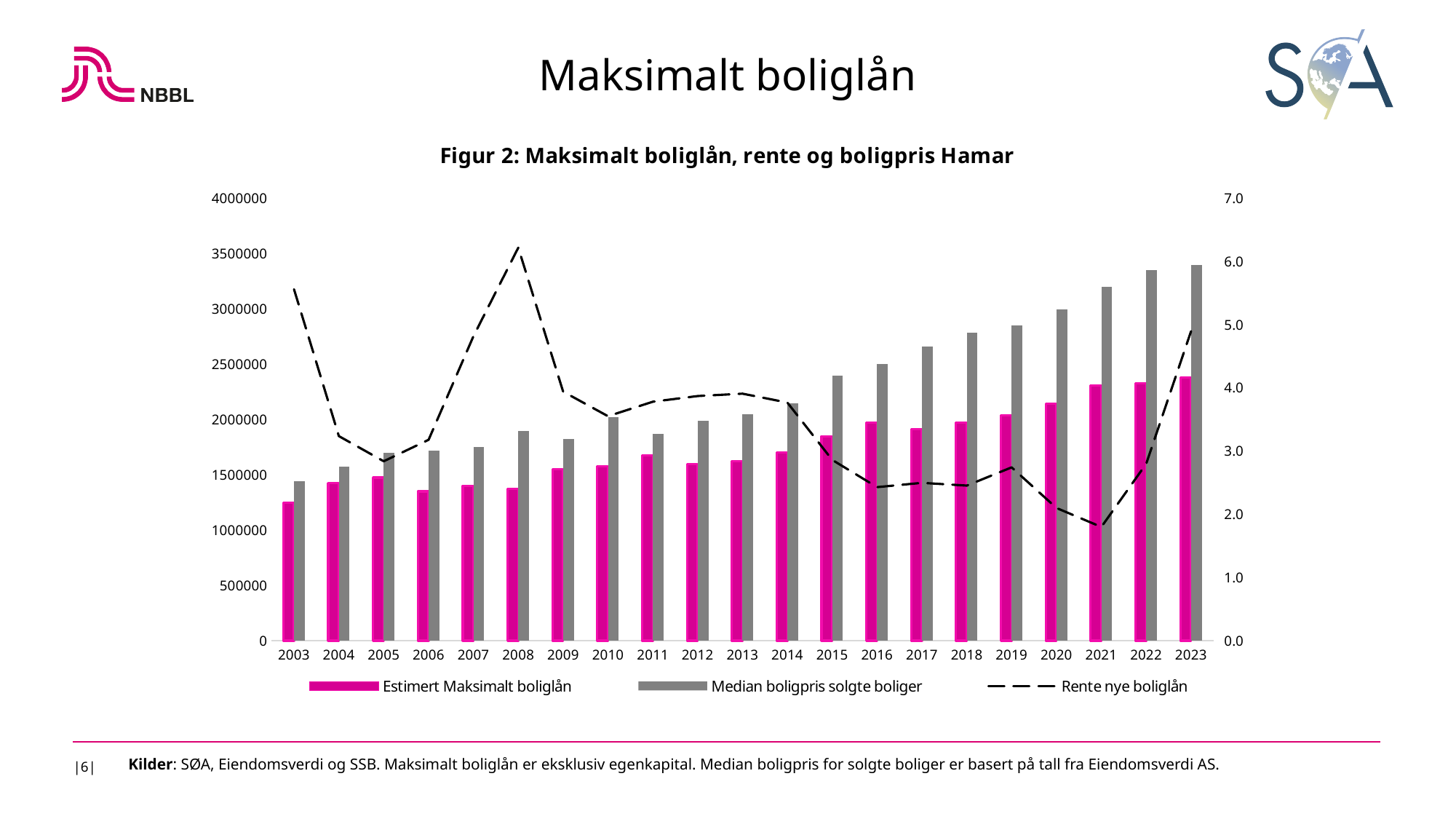
In which year does the Rente nye boliglån line reach its lowest point? 2021 In which year does the Rente nye boliglån line reach its highest point? 2008 Is the Rente nye boliglån value for 2021 greater or less than 2.0? less Is the Estimert Maksimalt boliglån value for 2003 greater or less than 1500000? less Which is larger in 2020: Estimert Maksimalt boliglån or Median boligpris solgte boliger? Median boligpris solgte boliger How many years are shown on the x axis? 21 What kind of chart is shown on the slide? bar and line chart In which year is the Median boligpris solgte boliger bar the lowest? 2003 In which year is the Estimert Maksimalt boliglån bar the lowest? 2003 Is the Median boligpris solgte boliger value for 2023 greater or less than 3000000? greater What is the title of the chart? Figur 2: Maksimalt boliglån, rente og boligpris Hamar How many series does the legend list? 3